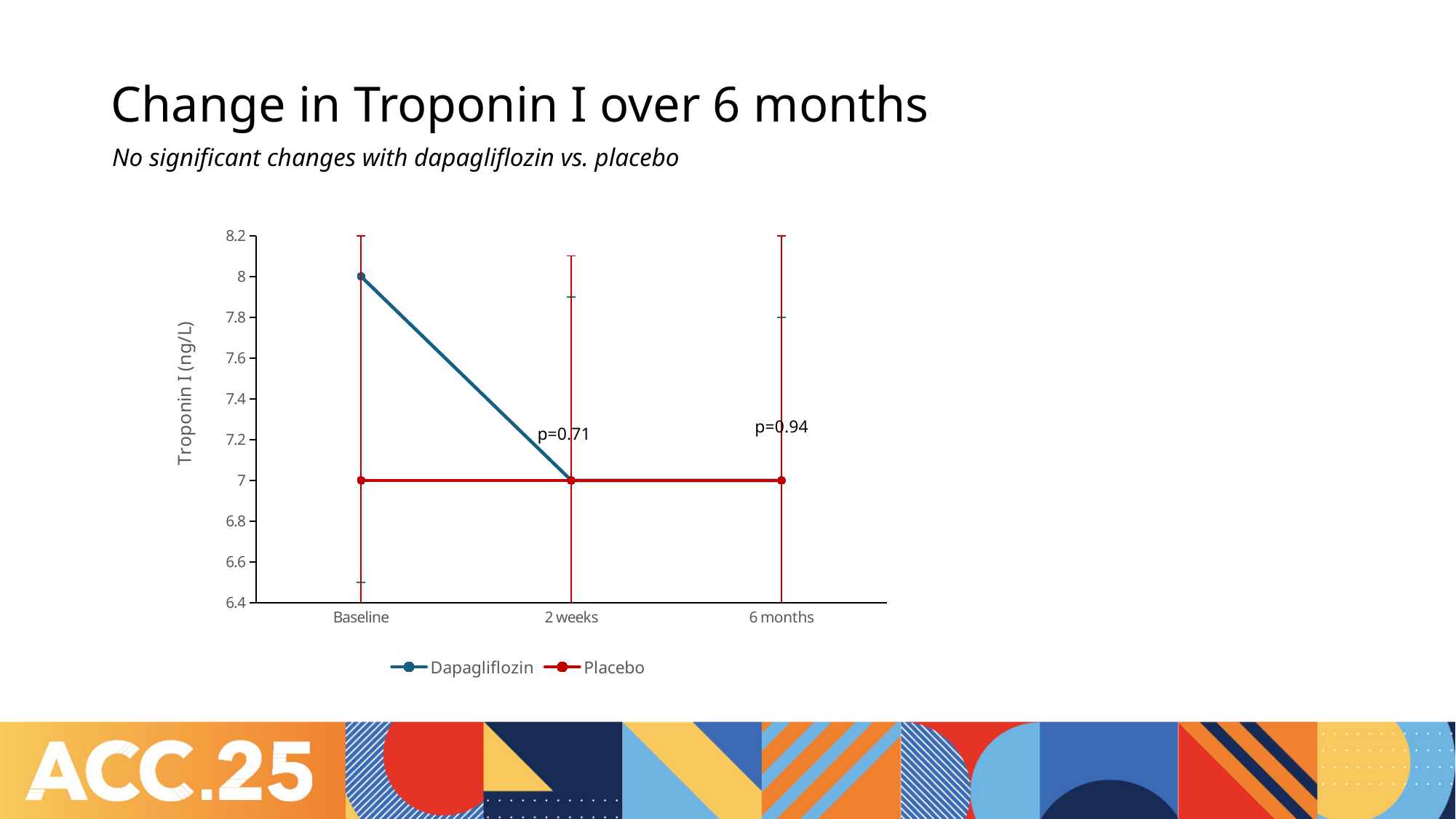
What is the Troponin I value for Dapagliflozin at 2 weeks? 7 What is the Troponin I value for Dapagliflozin at Baseline? 8 At Baseline, which series has the higher Troponin I value, Dapagliflozin or Placebo? Dapagliflozin What is the Troponin I value for Placebo at 6 months? 7 What is the difference between the Dapagliflozin and Placebo values at Baseline? 1 How many series does the legend list? 2 How many time points are plotted on the x axis? 3 What is the Troponin I value for Placebo at Baseline? 7 What kind of chart is shown on the slide? line chart What is the label of the y axis? Troponin I (ng/L) Does the Dapagliflozin line rise or fall from Baseline to 2 weeks? fall What p-value is shown at the 6 months time point? p=0.94